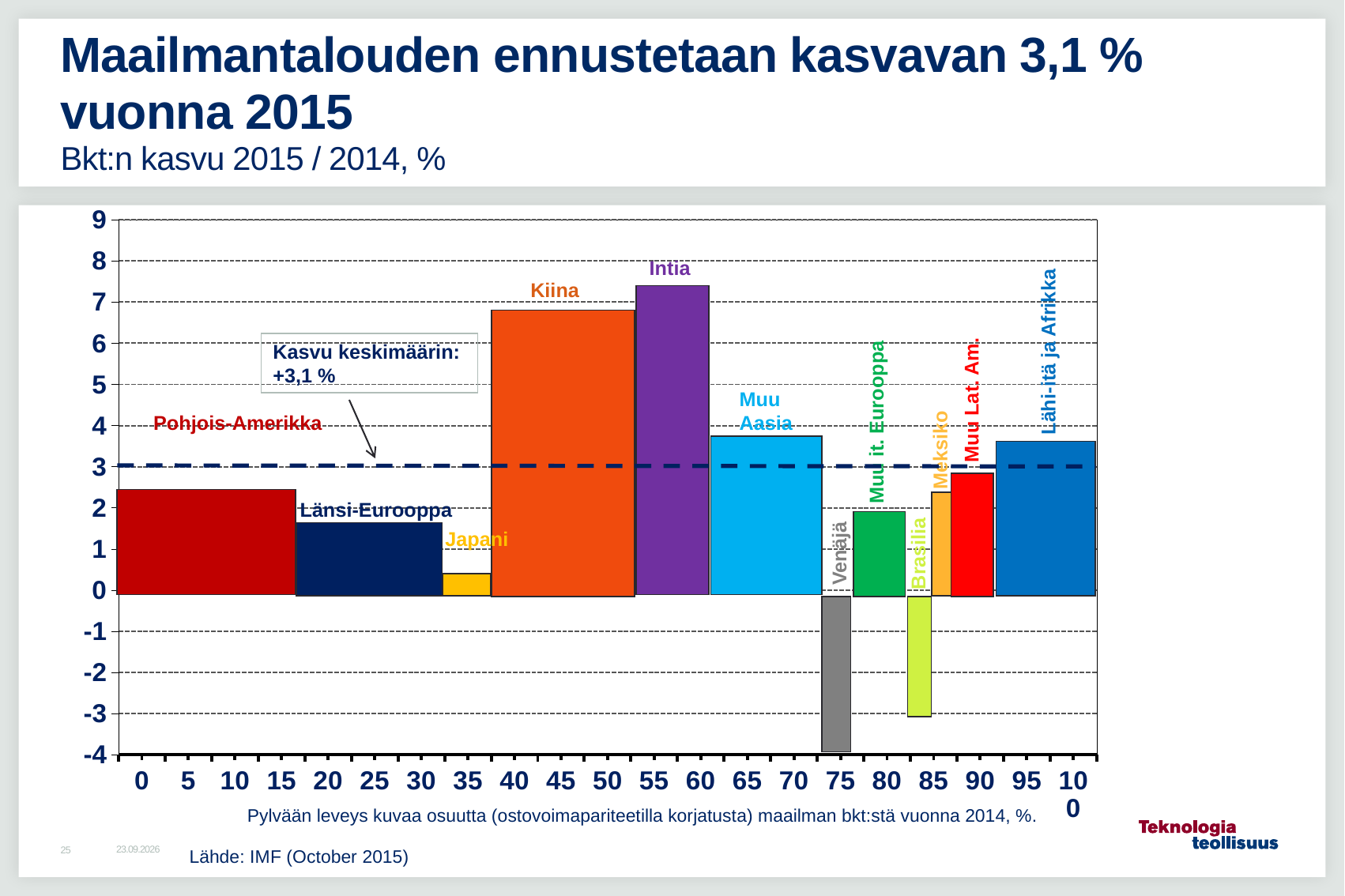
Which region has the lowest GDP growth in the chart? Venäjä Is the value for Pohjois-Amerikka greater or less than 3? less Is the value for Japani greater or less than 1? less Which has the higher growth, Pohjois-Amerikka or Länsi-Eurooppa? Pohjois-Amerikka How many regions are plotted as bars in the chart? 12 Is the value for Venäjä greater or less than -3? less Which region has the highest GDP growth in the chart? Intia Which has the higher growth, Kiina or Intia? Intia What kind of chart is shown on the slide? bar chart What average growth value is marked by the dashed line in the chart? +3,1 %